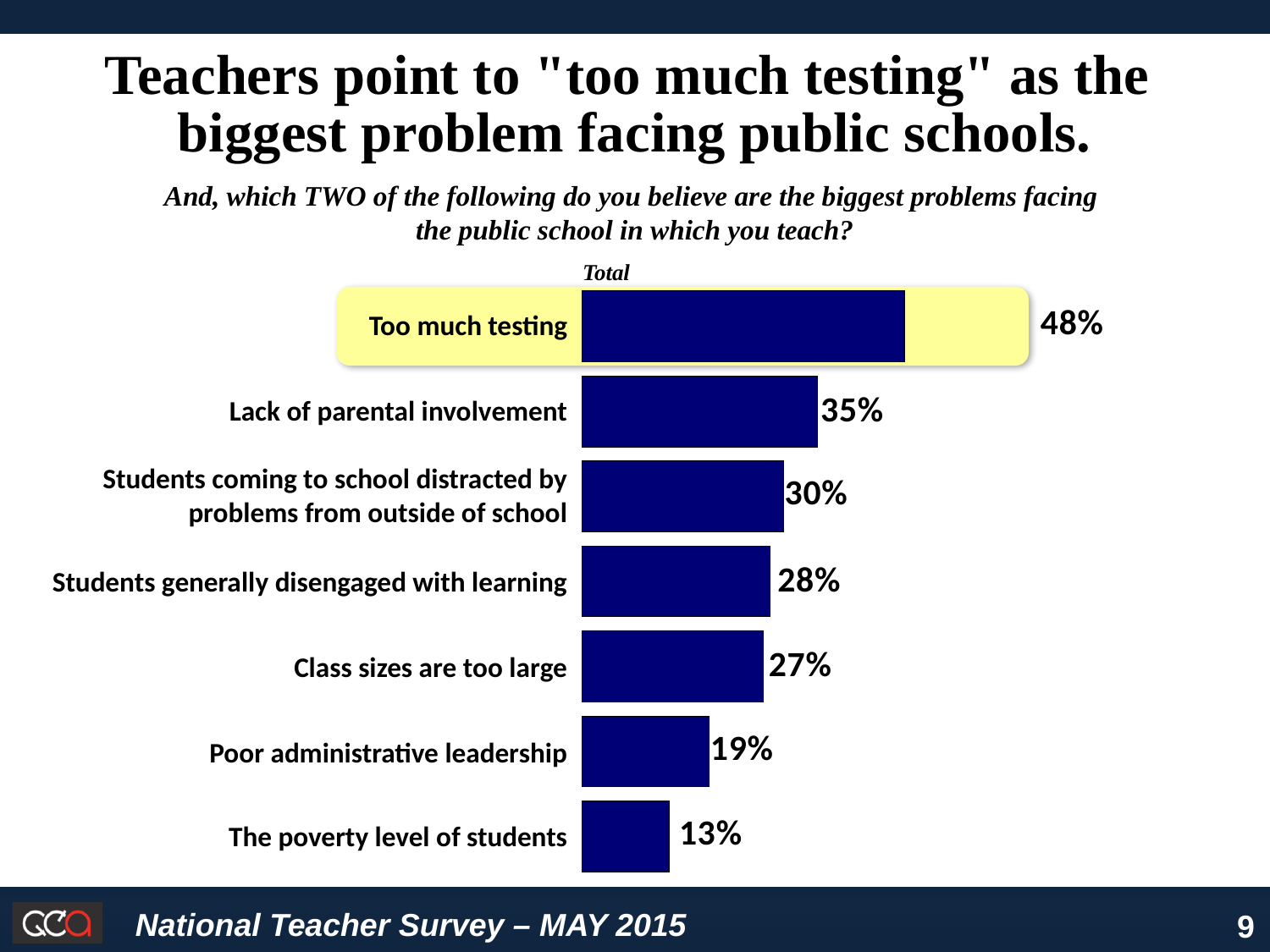
What kind of chart is shown on the slide? Bar chart Which is larger: "Students coming to school distracted by problems from outside of school" or "Class sizes are too large"? Students coming to school distracted by problems from outside of school What is the value for "Lack of parental involvement"? 35% What percentage of teachers chose "Too much testing" as one of the biggest problems? 48% Which category has the lowest value? The poverty level of students What is the value for "Class sizes are too large"? 27% What percentage is shown for "Poor administrative leadership"? 19% How many categories are shown in the chart? 7 Which category has the highest value? Too much testing What is the difference between "Too much testing" and "Lack of parental involvement"? 13% Which category's bar is highlighted with a yellow background? Too much testing What is the difference between "Students generally disengaged with learning" and "The poverty level of students"? 15%